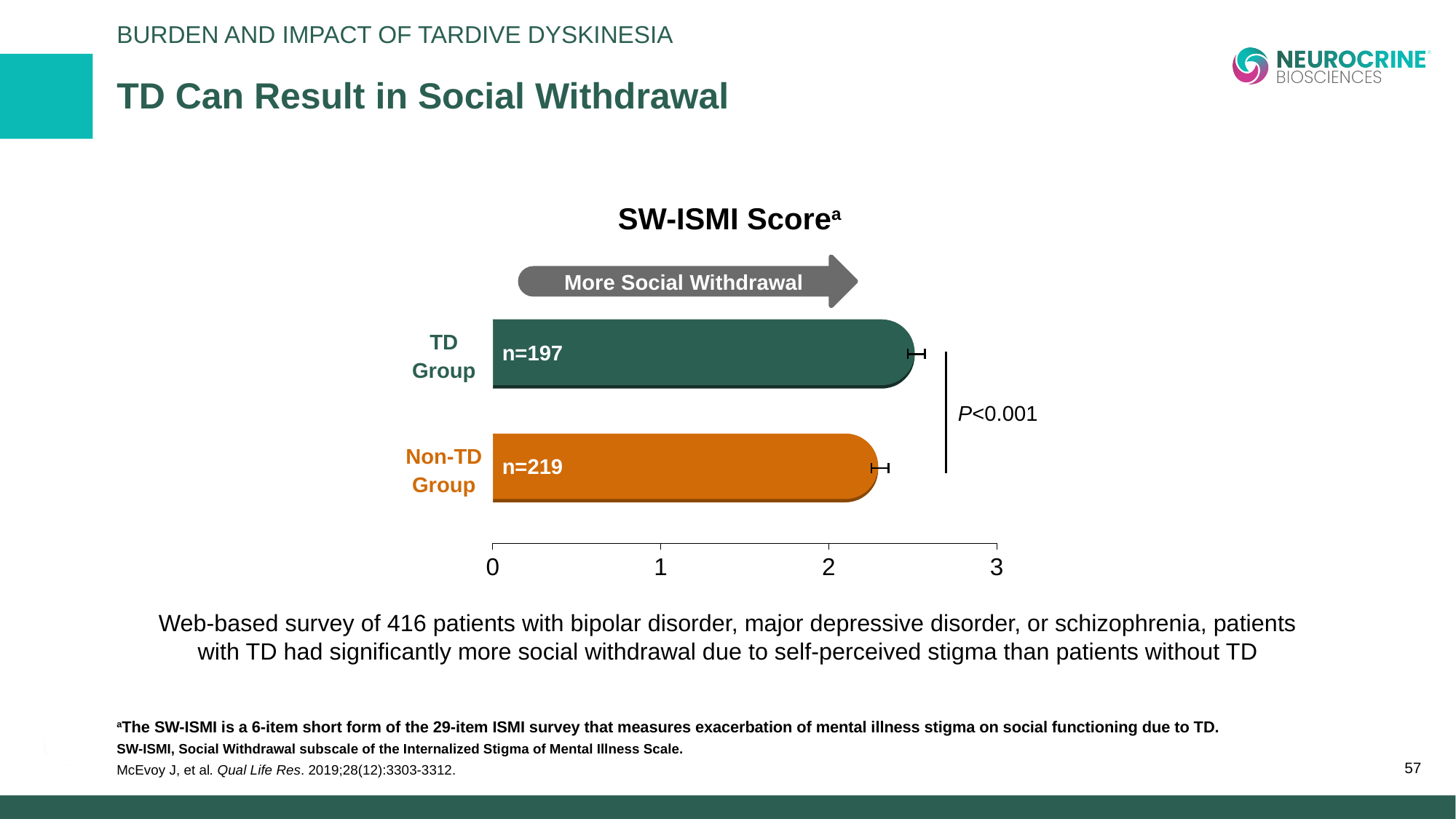
Is the SW-ISMI score for the TD Group greater or less than 3? less What is the sample size (n) shown on the Non-TD Group bar? n=219 Is the SW-ISMI score for the Non-TD Group greater or less than 1? greater What P value is shown for the comparison between the TD Group and Non-TD Group bars? P<0.001 What is the sample size (n) shown on the TD Group bar? n=197 Is the SW-ISMI score for the Non-TD Group greater or less than 2? greater Which group has the lower SW-ISMI score? Non-TD Group How many groups are plotted in the SW-ISMI Score chart? 2 Is the SW-ISMI score for the TD Group larger or smaller than that for the Non-TD Group? larger Which group has the higher SW-ISMI score? TD Group What kind of chart is shown on the slide? bar chart